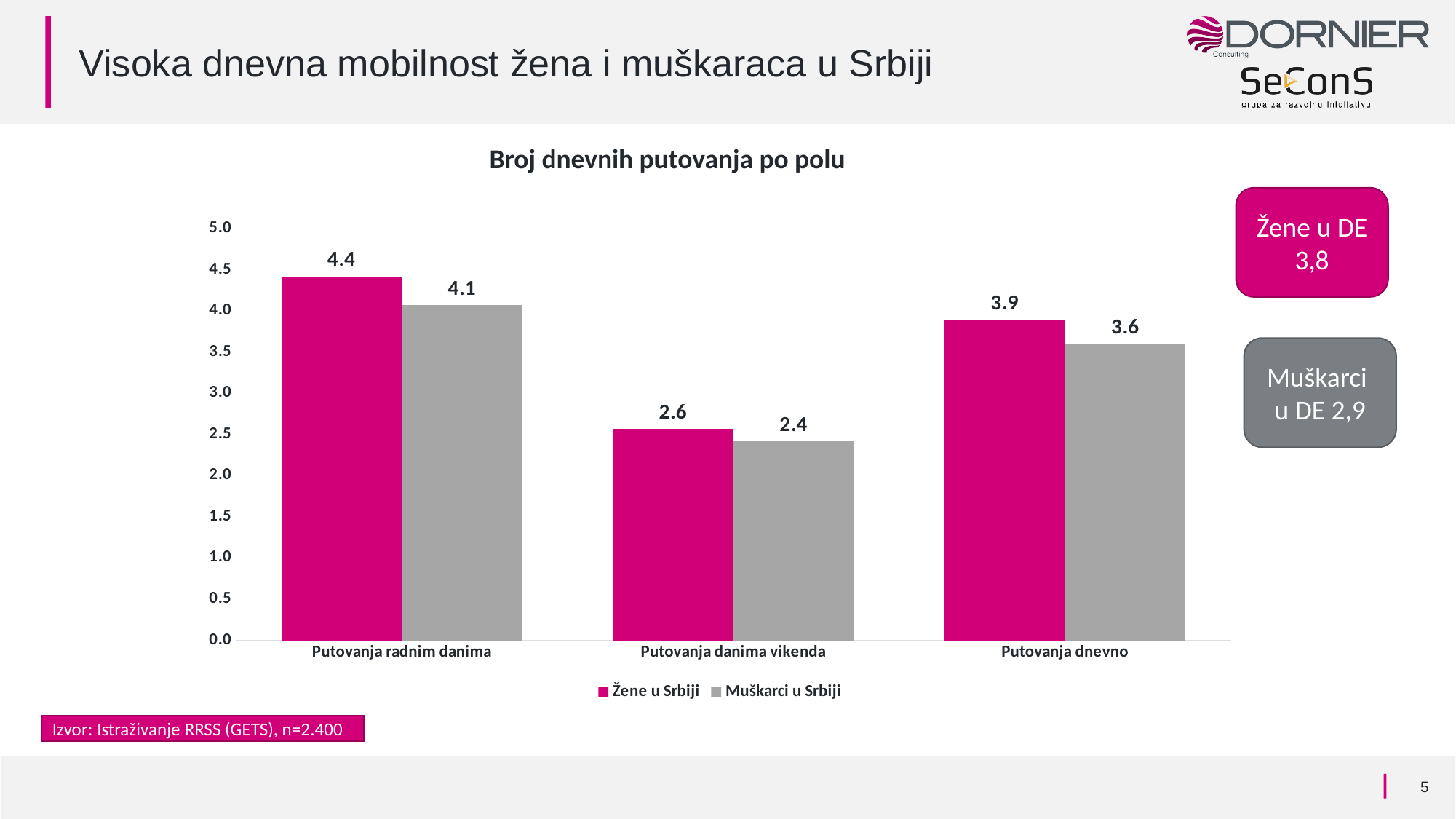
What kind of chart is shown on the slide? Bar chart What is the title of the chart? Broj dnevnih putovanja po polu Which category has the lowest value for Muškarci u Srbiji? Putovanja danima vikenda What is the value for Muškarci u Srbiji in the Putovanja radnim danima category? 4.1 Which category has the highest value for Žene u Srbiji? Putovanja radnim danima In the Putovanja danima vikenda category, which series has the larger value, Žene u Srbiji or Muškarci u Srbiji? Žene u Srbiji What is the value for Žene u Srbiji in the Putovanja dnevno category? 3.9 What is the value for Žene u Srbiji in the Putovanja radnim danima category? 4.4 What is the difference between Žene u Srbiji and Muškarci u Srbiji in the Putovanja dnevno category? 0.3 How many series does the chart legend list? 2 How many categories are shown on the x axis of the chart? 3 What is the value for Muškarci u Srbiji in the Putovanja danima vikenda category? 2.4